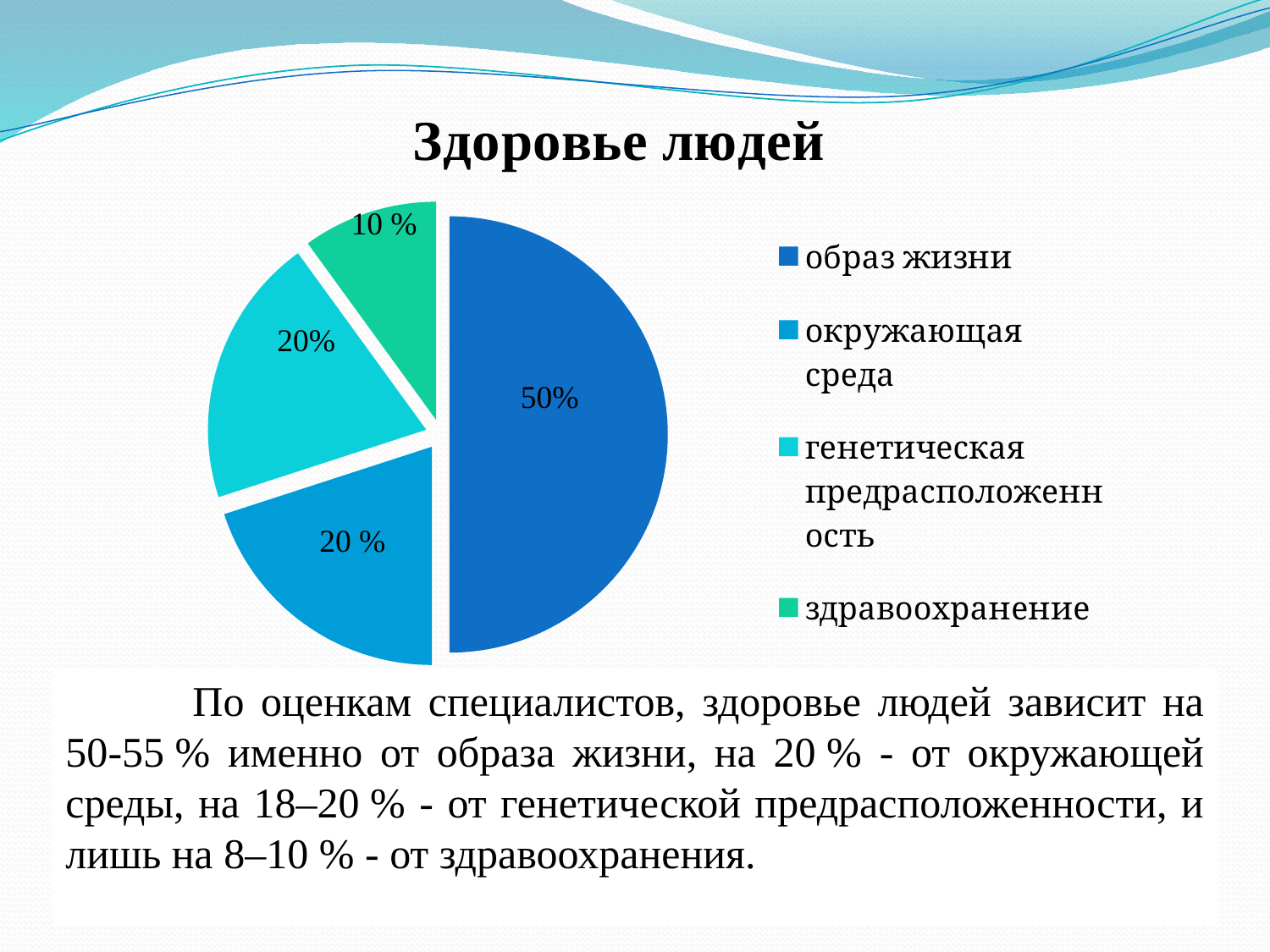
What is the title of the chart? Здоровье людей Which category has the smallest slice of the pie? здравоохранение What share of the pie is labelled for генетическая предрасположенность? 20% Which category has the largest slice of the pie? образ жизни How many slices does the pie chart have? 4 How many entries does the legend list? 4 What share of the pie is labelled for здравоохранение? 10 % What is the difference in percentage points between the образ жизни slice and the здравоохранение slice? 40 What share of the pie is labelled for образ жизни? 50% What share of the pie is labelled for окружающая среда? 20 % Which slice is larger: образ жизни or окружающая среда? образ жизни What type of chart is shown on the slide? pie chart